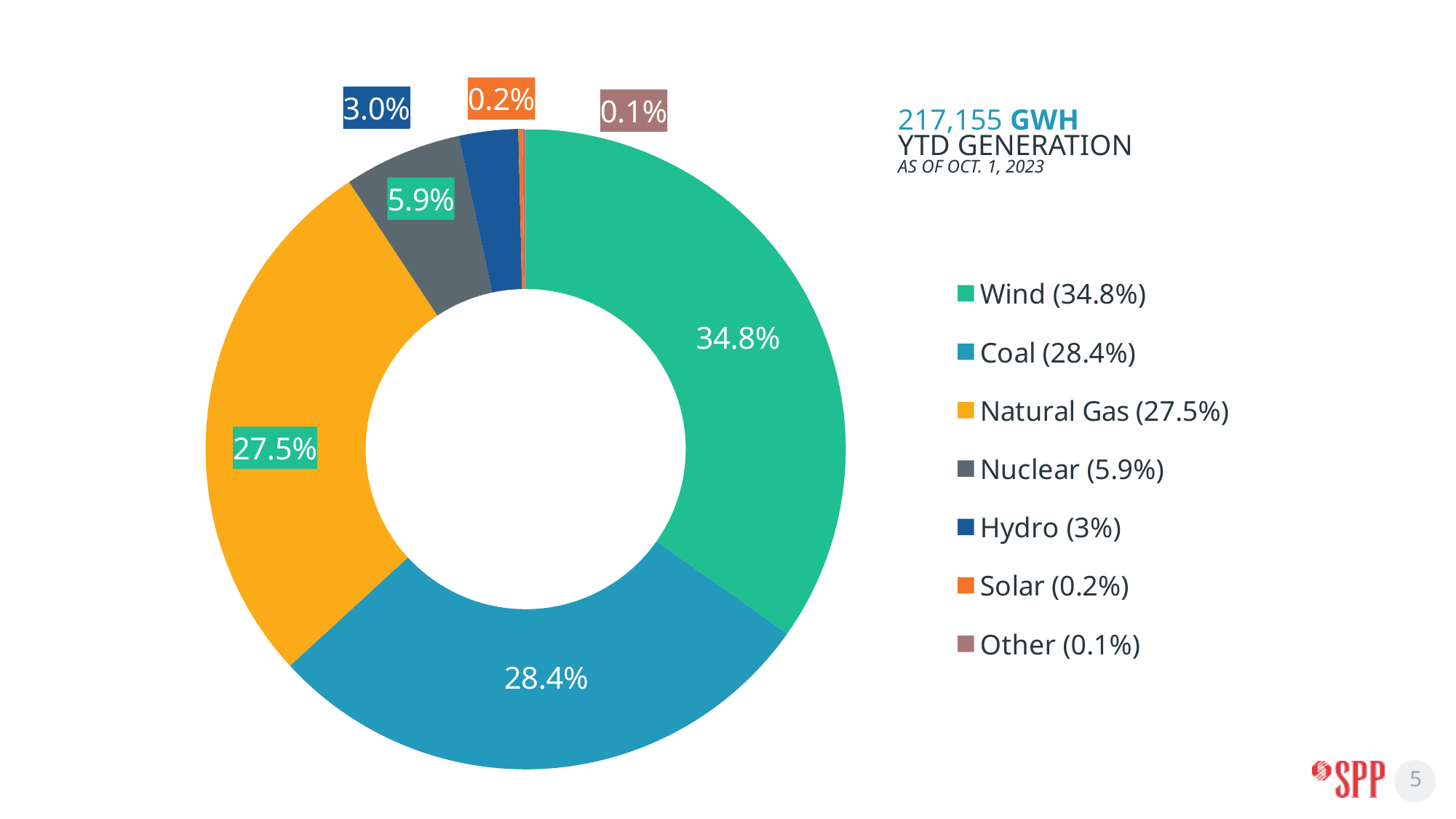
What share of YTD generation comes from Wind? 34.8% How many generation sources are shown in the chart? 7 What kind of chart is shown on the slide? Pie chart (donut) What is the difference in percentage points between the Wind and Coal shares? 6.4 Which has a larger share of YTD generation, Coal or Natural Gas? Coal What share of YTD generation comes from Nuclear? 5.9% Which source has the largest share of YTD generation? Wind What share of YTD generation comes from Natural Gas? 27.5% Which source has the smallest share of YTD generation? Other What share of YTD generation comes from Solar? 0.2% What is the difference in percentage points between the Nuclear and Hydro shares? 2.9 What total YTD generation in GWh is stated on the slide? 217,155 GWH